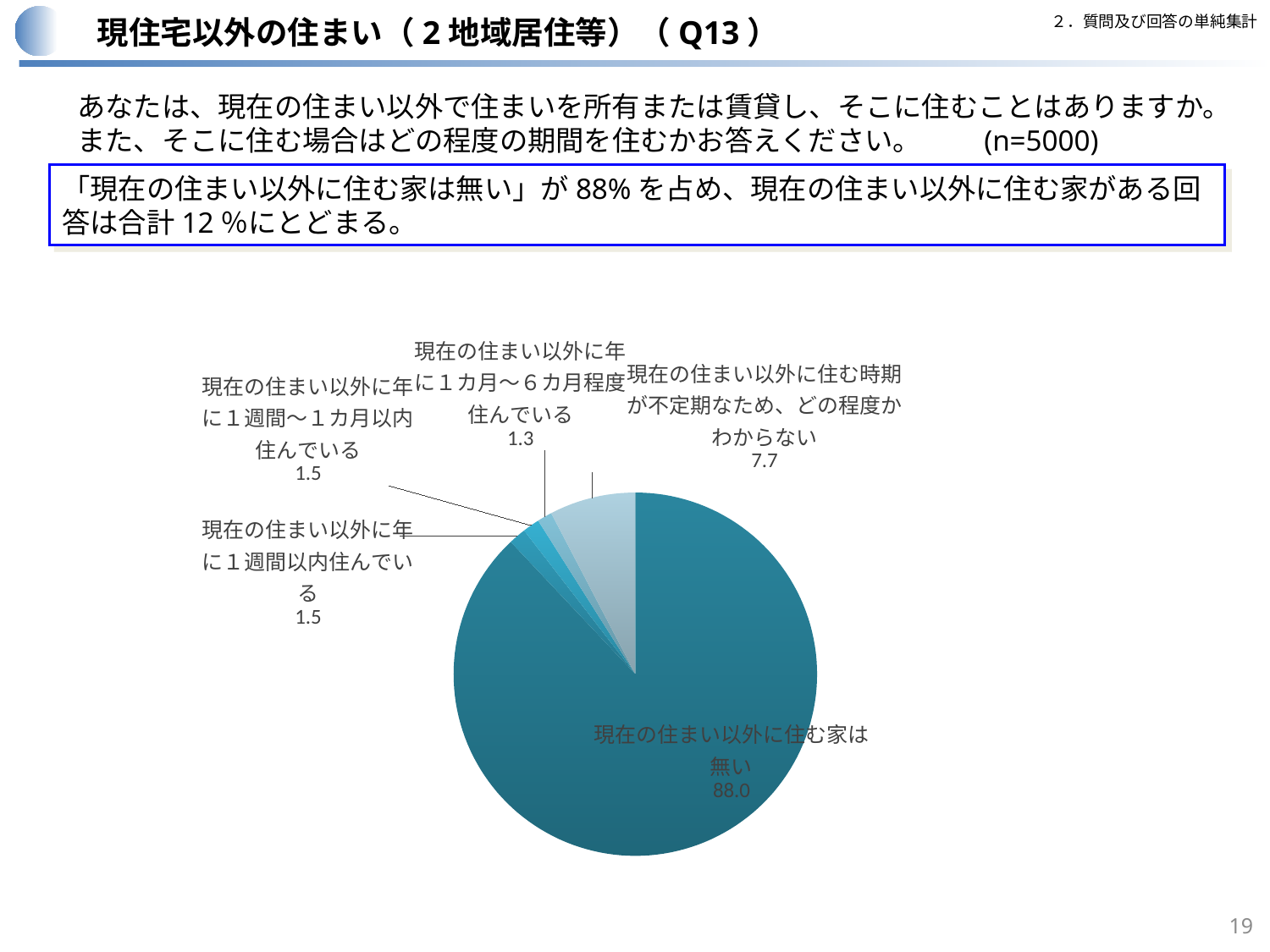
What type of chart is shown on the slide? pie chart What is the value shown for 「現在の住まい以外に住む家は無い」? 88.0 What is the value shown for 「現在の住まい以外に年に１週間～１カ月以内住んでいる」? 1.5 Which category has the smallest slice of the pie chart? 現在の住まい以外に年に１カ月～６カ月程度住んでいる What is the value shown for 「現在の住まい以外に年に１カ月～６カ月程度住んでいる」? 1.3 What is the value shown for 「現在の住まい以外に住む時期が不定期なため、どの程度かわからない」? 7.7 What is the sample size (n) stated on the slide for this question? n=5000 What is the value shown for 「現在の住まい以外に年に１週間以内住んでいる」? 1.5 What is the difference between the values for 「現在の住まい以外に住む家は無い」 and 「現在の住まい以外に住む時期が不定期なため、どの程度かわからない」? 80.3 How many slices does the pie chart have? 5 Which category has the largest slice of the pie chart? 現在の住まい以外に住む家は無い Which is larger: the value for 「現在の住まい以外に住む時期が不定期なため、どの程度かわからない」 or for 「現在の住まい以外に年に１カ月～６カ月程度住んでいる」? 現在の住まい以外に住む時期が不定期なため、どの程度かわからない